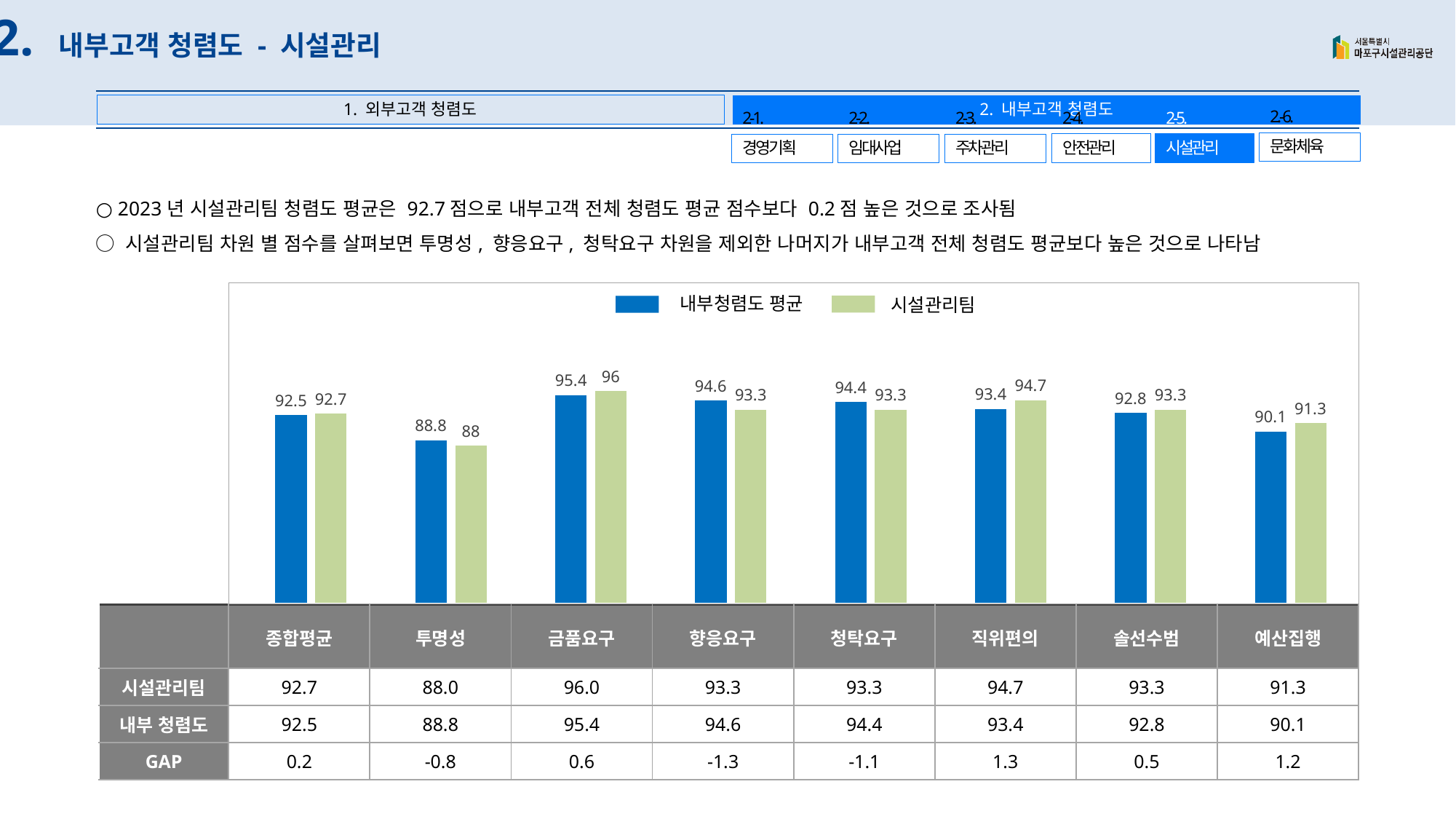
How many series does the chart legend list? 2 What is the value for 시설관리팀 in the 예산집행 category? 91.3 In the 청탁요구 category, which series has the larger value, 내부청렴도 평균 or 시설관리팀? 내부청렴도 평균 Which category has the highest value for 시설관리팀? 금품요구 In the 솔선수범 category, which series has the larger value, 내부청렴도 평균 or 시설관리팀? 시설관리팀 How many categories are shown on the x axis of the chart? 8 Which colour represents the 시설관리팀 series in the chart? Light green Which category has the lowest value for 내부청렴도 평균? 투명성 What kind of chart is shown on the slide? Bar chart What is the value for 내부청렴도 평균 in the 향응요구 category? 94.6 What is the difference between 시설관리팀 and 내부청렴도 평균 in the 직위편의 category? 1.3 What is the value for 시설관리팀 in the 금품요구 category? 96